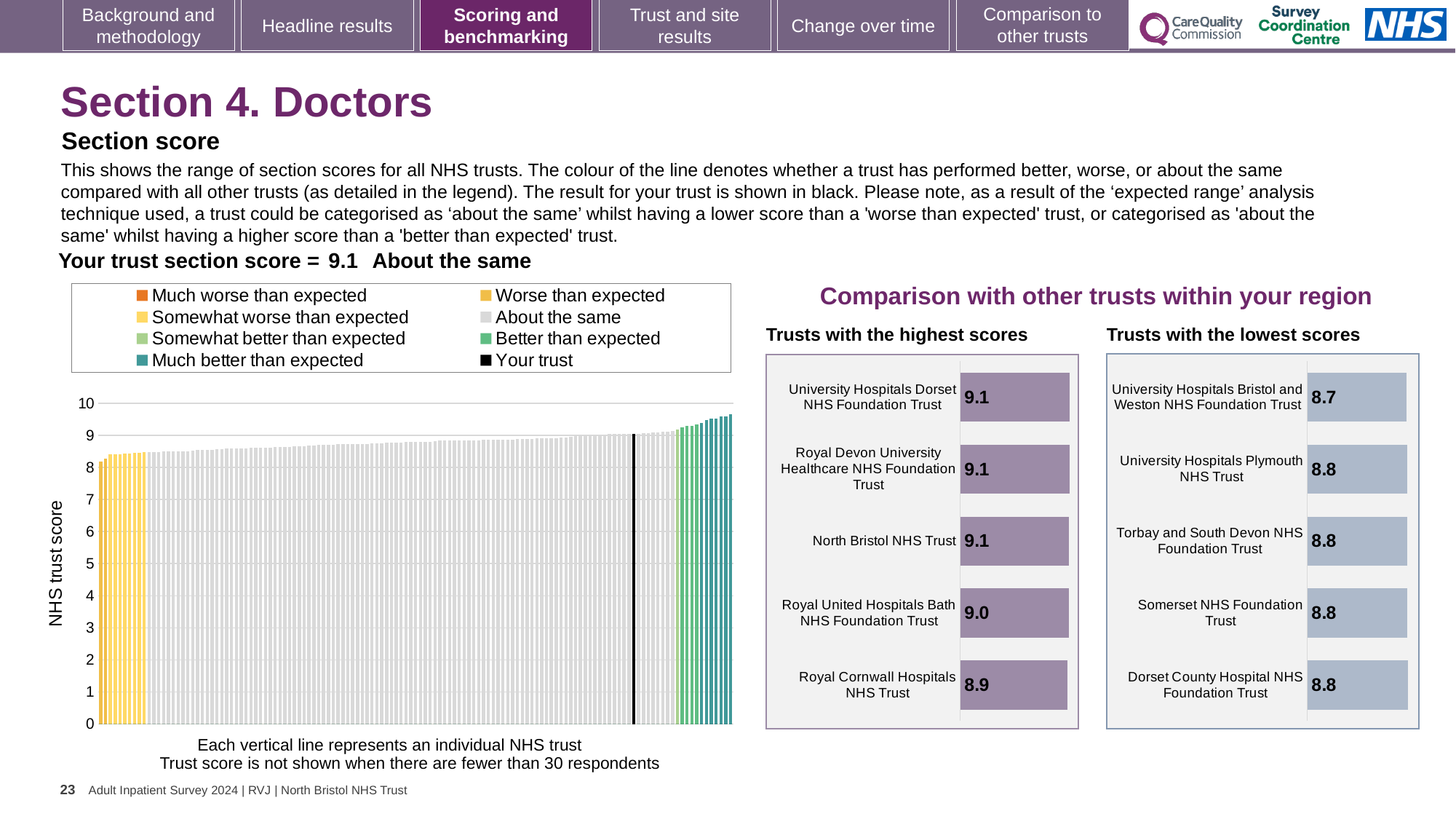
How many trusts are listed in the 'Trusts with the highest scores' chart? 5 In the 'Trusts with the lowest scores' chart, which trust has the lowest score? University Hospitals Bristol and Weston NHS Foundation Trust What kind of chart is the NHS trust score chart on the left of the slide? bar chart How many entries does the legend of the NHS trust score chart on the left list? 8 In the 'Trusts with the highest scores' chart, which trust has the lowest score shown? Royal Cornwall Hospitals NHS Trust In the 'Trusts with the lowest scores' chart, what is the score for University Hospitals Bristol and Weston NHS Foundation Trust? 8.7 In the 'Trusts with the highest scores' chart, what is the difference between the scores of University Hospitals Dorset NHS Foundation Trust and Royal Cornwall Hospitals NHS Trust? 0.2 How many trusts are listed in the 'Trusts with the lowest scores' chart? 5 In the 'Trusts with the highest scores' chart, what is the score for Royal Cornwall Hospitals NHS Trust? 8.9 In the NHS trust score chart on the left, is the value of the tallest bar greater or less than 9? greater In the 'Trusts with the lowest scores' chart, what is the difference between the scores of University Hospitals Plymouth NHS Trust and University Hospitals Bristol and Weston NHS Foundation Trust? 0.1 In the 'Trusts with the highest scores' chart, which has the higher score: Royal United Hospitals Bath NHS Foundation Trust or Royal Cornwall Hospitals NHS Trust? Royal United Hospitals Bath NHS Foundation Trust